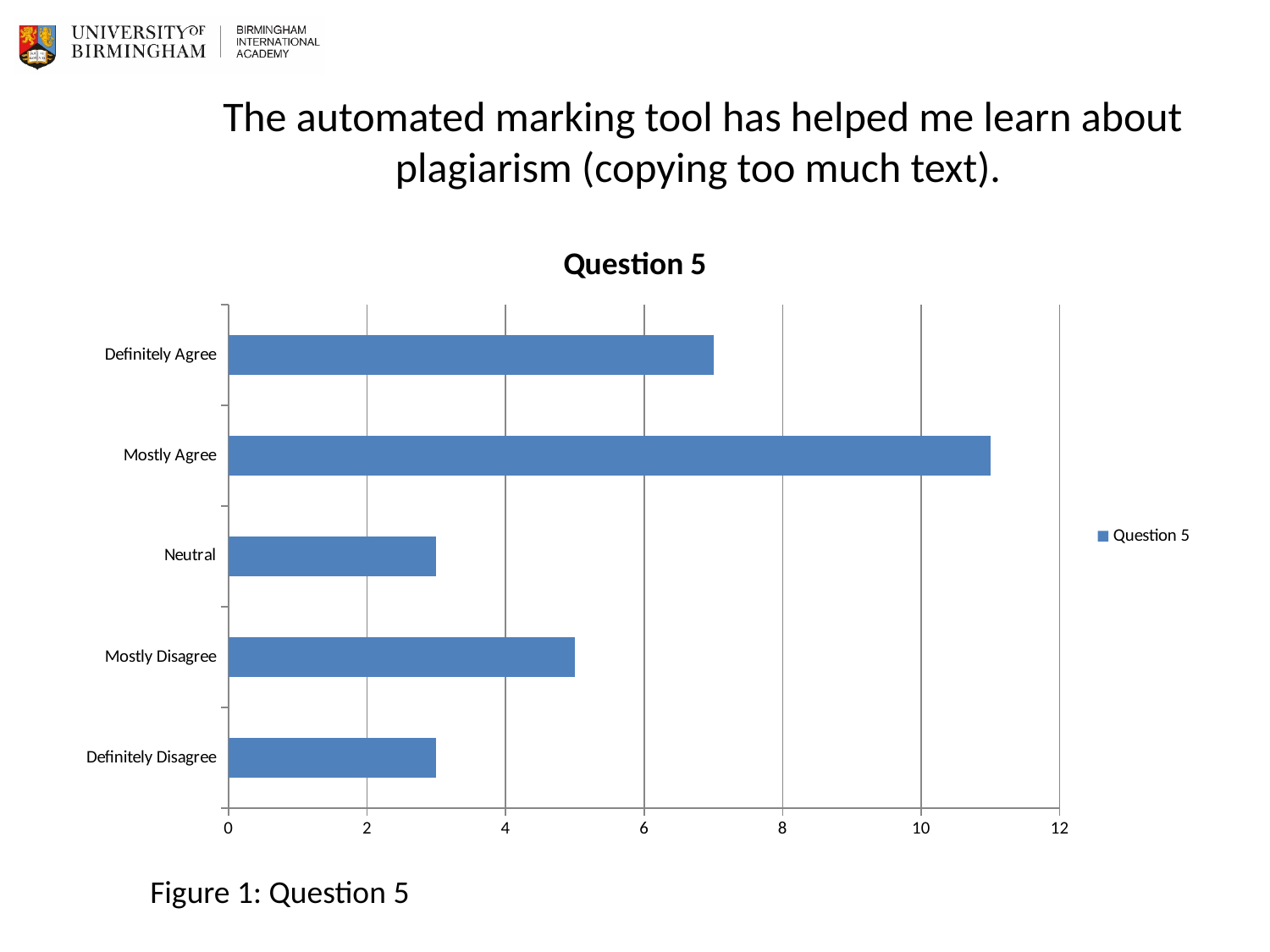
Is the value for Definitely Agree greater or less than 6? greater Is the value for Mostly Disagree greater or less than 4? greater Is the value for Definitely Disagree greater or less than 4? less How many series does the legend list? 1 What kind of chart is shown on the slide? bar chart What is the title of the chart? Question 5 Which category has the highest value? Mostly Agree What is the name of the series shown in the legend? Question 5 How many categories are shown on the chart? 5 Which is larger, the value for Definitely Agree or the value for Mostly Disagree? Definitely Agree